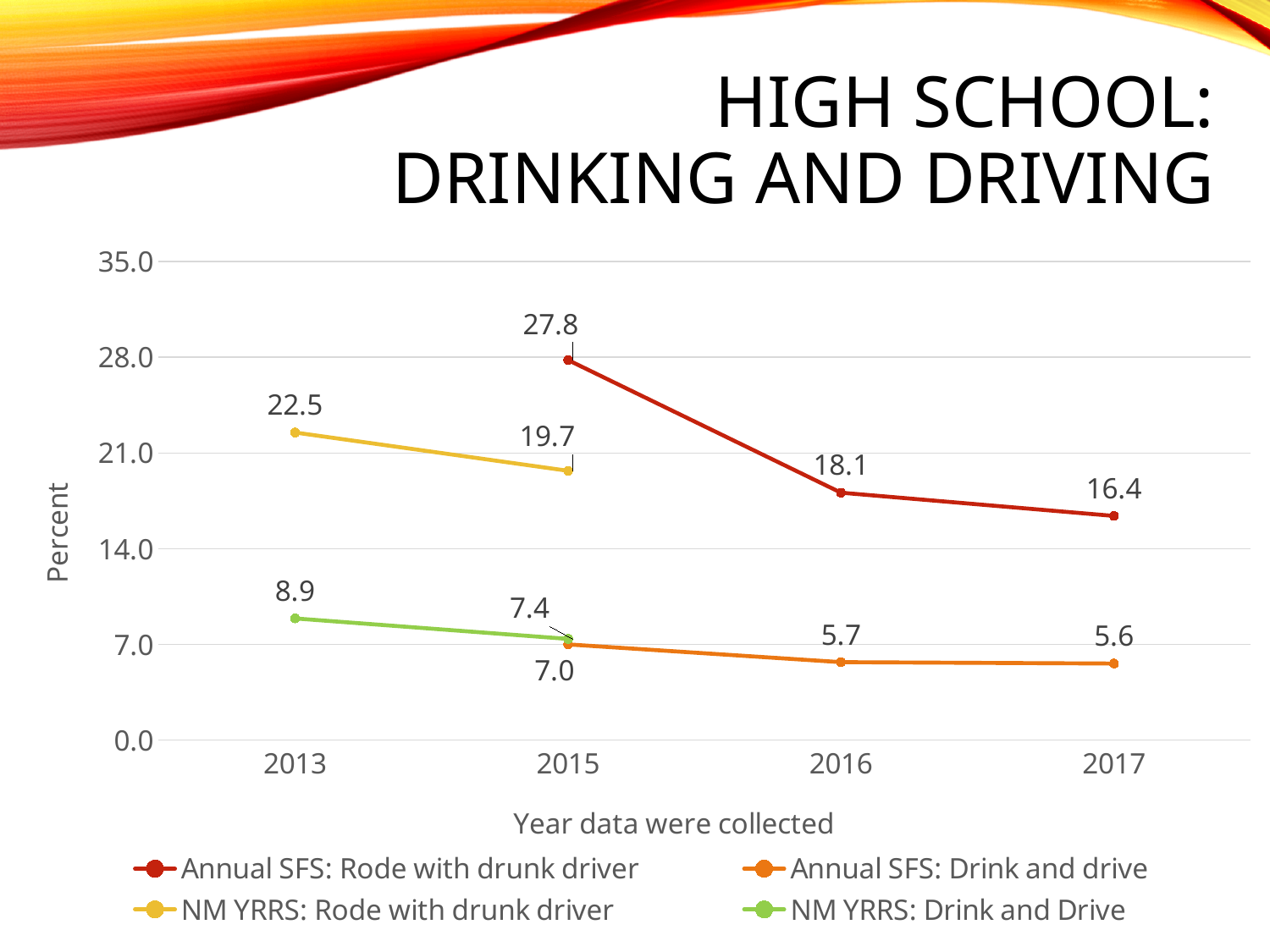
How many series does the legend list? 4 What kind of chart is shown on the slide? Line chart In which year is the Annual SFS: Drink and drive series lowest? 2017 Which is larger in 2013: NM YRRS: Rode with drunk driver or NM YRRS: Drink and Drive? NM YRRS: Rode with drunk driver What is the value for NM YRRS: Drink and Drive in 2015? 7.4 What is the value for Annual SFS: Drink and drive in 2017? 5.6 What is the value for NM YRRS: Rode with drunk driver in 2013? 22.5 In which year is the Annual SFS: Rode with drunk driver series highest? 2015 Does the Annual SFS: Rode with drunk driver series rise or fall from 2015 to 2017? Fall How many years are shown on the x axis? 4 What is the value for Annual SFS: Rode with drunk driver in 2015? 27.8 What is the difference between the Annual SFS: Rode with drunk driver values for 2015 and 2016? 9.7